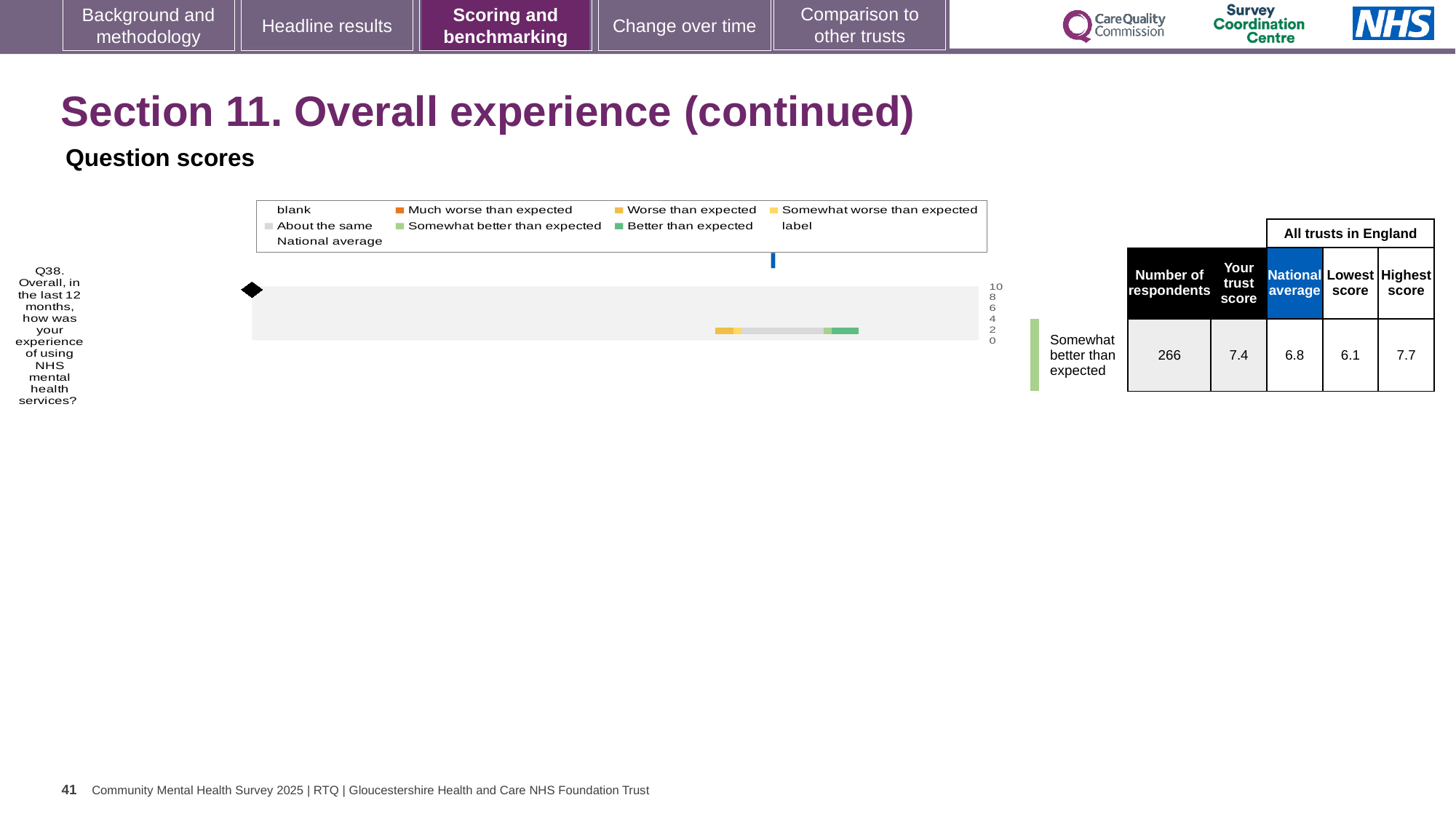
How many respondents answered Q38? 266 Which colour in the legend represents 'Much worse than expected'? orange What benchmark category is Q38 assigned to on the slide? Somewhat better than expected How many survey questions are plotted in the chart? 1 What is the national average for Q38 shown in the table beside the chart? 6.8 What is the difference between the trust score and the national average for Q38? 0.6 What is the highest score among all trusts in England for Q38? 7.7 What is the highest value shown on the chart's numeric axis? 10 What is the trust score for Q38 shown in the table beside the chart? 7.4 What is the lowest score among all trusts in England for Q38? 6.1 Which is larger for Q38, the trust score or the national average? trust score What kind of chart is shown for Q38 on the slide? bar chart